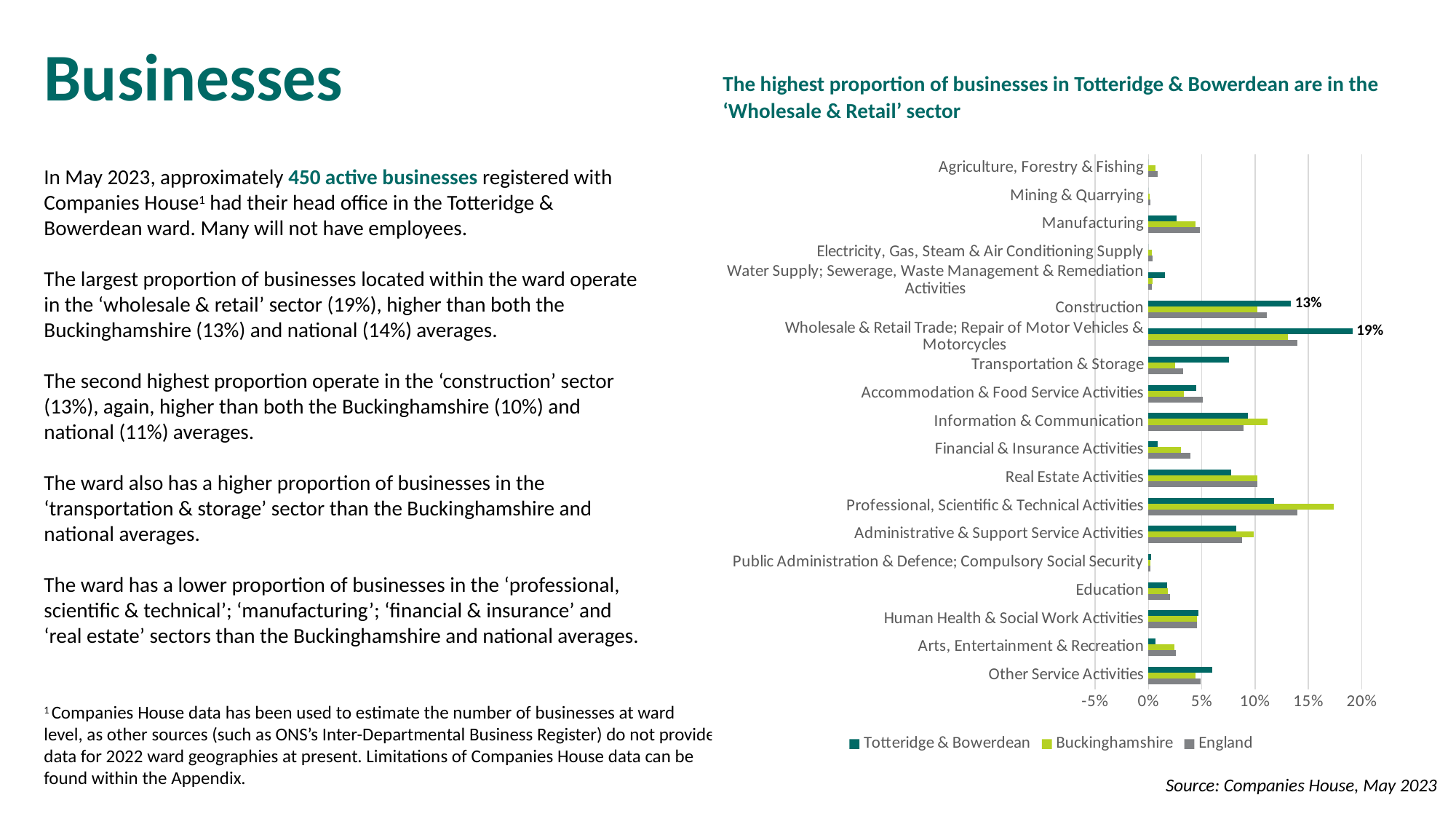
How many series does the legend list? 3 Is the Buckinghamshire value for 'Professional, Scientific & Technical Activities' greater or less than 15%? greater Which sector has the highest value for Totteridge & Bowerdean? Wholesale & Retail Trade; Repair of Motor Vehicles & Motorcycles What is the value for Totteridge & Bowerdean in the 'Construction' sector? 13% What is the source cited for the chart? Companies House, May 2023 In the 'Transportation & Storage' sector, which is larger: the Totteridge & Bowerdean value or the Buckinghamshire value? Totteridge & Bowerdean What is the value for Totteridge & Bowerdean in the 'Wholesale & Retail Trade; Repair of Motor Vehicles & Motorcycles' sector? 19% What kind of chart is shown on the slide? Bar chart In the 'Professional, Scientific & Technical Activities' sector, which is larger: the Totteridge & Bowerdean value or the Buckinghamshire value? Buckinghamshire How many sectors (categories) are plotted on the chart? 19 What is the difference between the Totteridge & Bowerdean values for 'Wholesale & Retail Trade' and 'Construction'? 6% Is the England value for 'Real Estate Activities' greater or less than 5%? greater